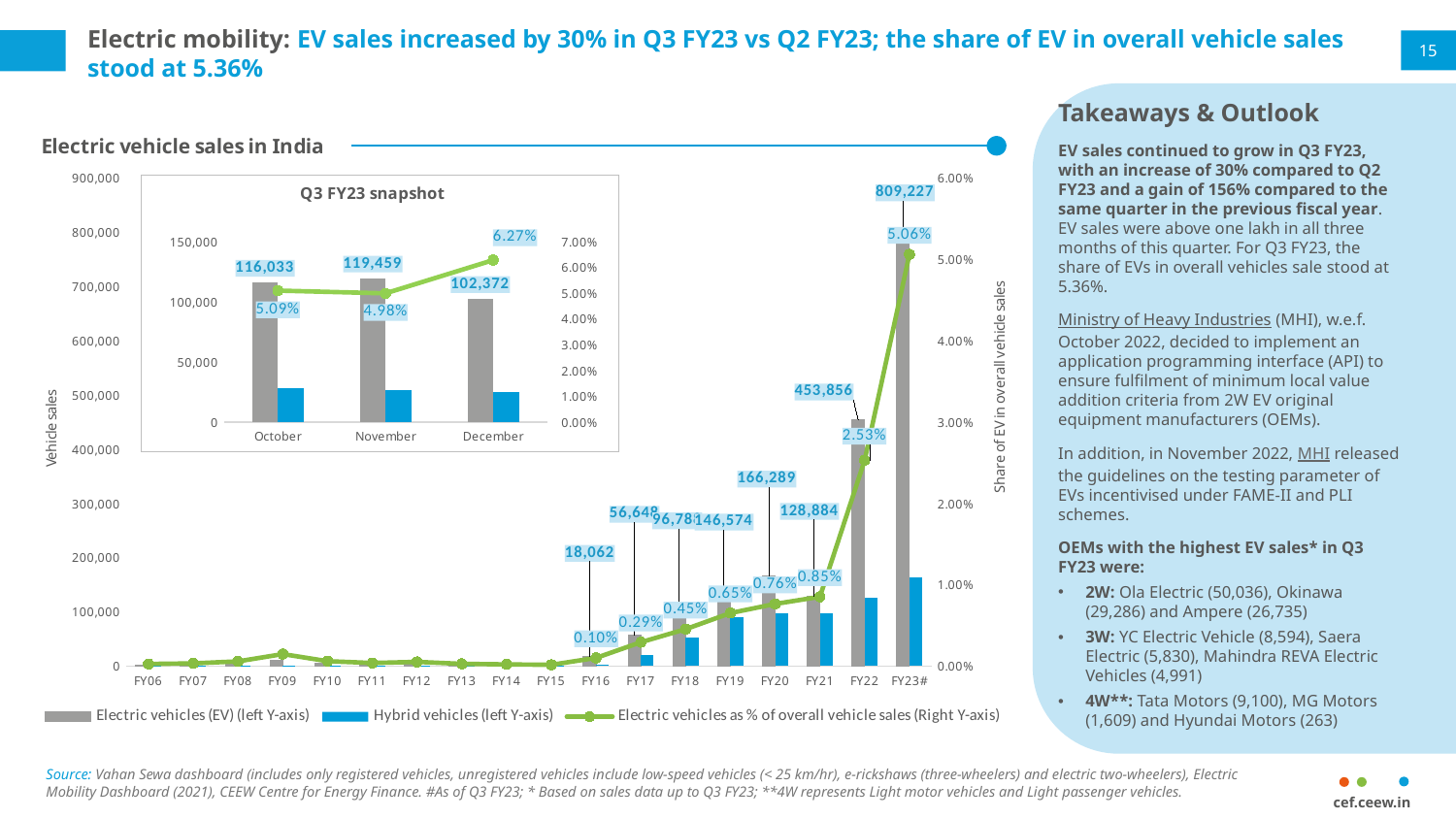
In the 'Q3 FY23 snapshot' chart, what is the difference in electric vehicle sales between November and December? 17,087 In the 'Electric vehicle sales in India' chart, what is the difference in electric vehicle sales between FY23# and FY22? 355,371 In the 'Q3 FY23 snapshot' chart, which month has the highest share of EV in overall vehicle sales? December In the 'Electric vehicle sales in India' chart, how many series does the legend list? 3 In the 'Electric vehicle sales in India' chart, which fiscal year has the highest electric vehicle sales? FY23# In the 'Electric vehicle sales in India' chart, what is the electric vehicle sales value labelled for FY22? 453,856 In the 'Electric vehicle sales in India' chart, what share of overall vehicle sales did electric vehicles have in FY23#? 5.06% In the 'Electric vehicle sales in India' chart, how many fiscal years are shown on the x axis? 18 In the 'Electric vehicle sales in India' chart, what is the electric vehicle sales value labelled for FY23#? 809,227 In the 'Electric vehicle sales in India' chart, what kind of chart is used to show electric vehicles as % of overall vehicle sales? Line chart In the 'Q3 FY23 snapshot' chart, what is the electric vehicle sales value for November? 119,459 In the 'Electric vehicle sales in India' chart, which is larger: electric vehicle sales in FY20 or FY21? FY20